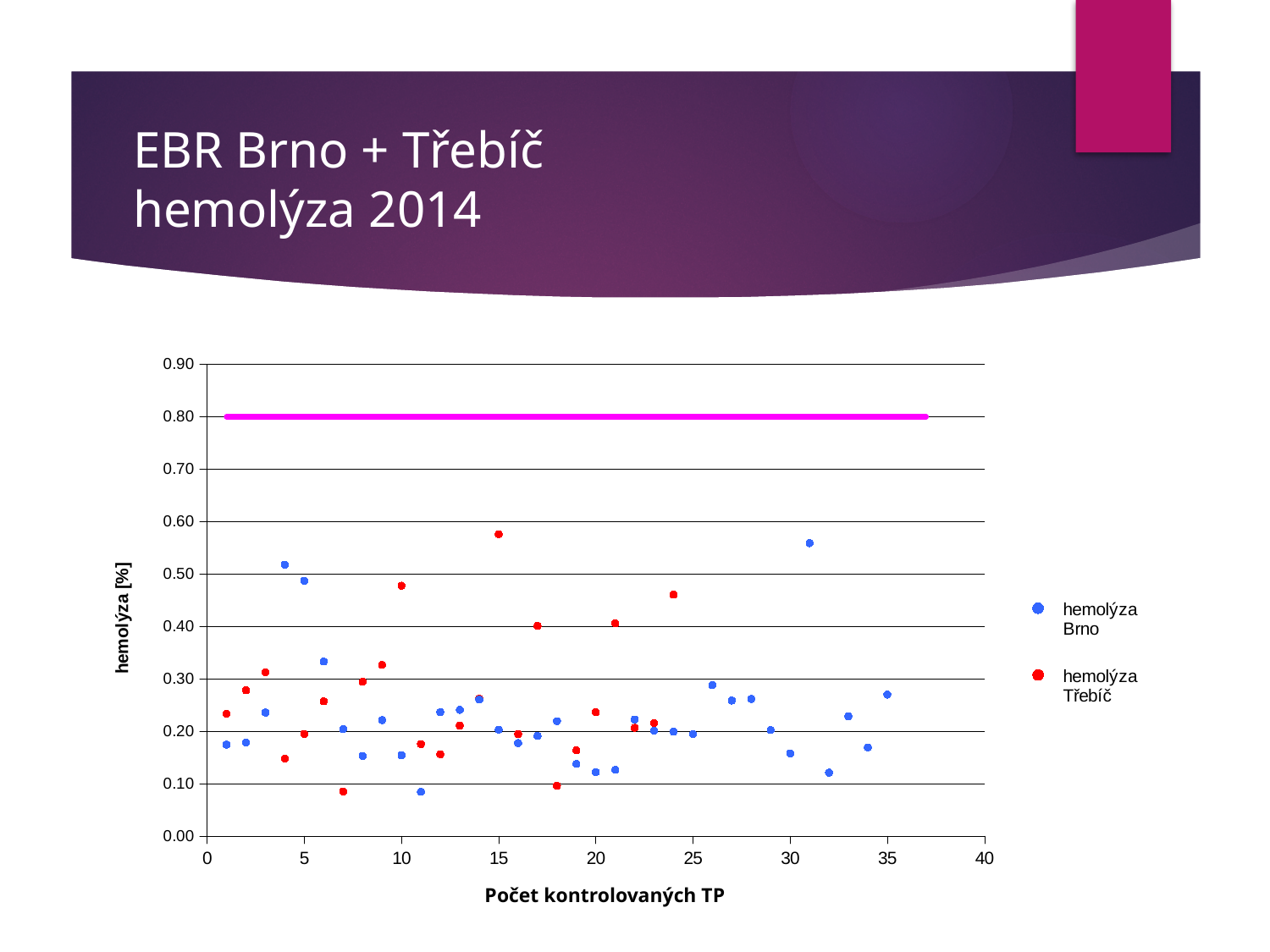
At x = 10, which series has the larger value, hemolýza Brno or hemolýza Třebíč? hemolýza Třebíč Is the hemolýza Třebíč value at x = 7 greater or less than 0.10? less Is the hemolýza Brno value at x = 11 greater or less than 0.10? less At what y-axis value is the horizontal magenta line drawn? 0.80 Is the hemolýza Brno value at x = 31 greater or less than 0.50? greater At x = 4, which series has the larger value, hemolýza Brno or hemolýza Třebíč? hemolýza Brno What kind of chart is shown on the slide? scatter chart What is the title of the x axis? Počet kontrolovaných TP How many series does the legend list? 2 What are the two series named in the legend? hemolýza Brno and hemolýza Třebíč